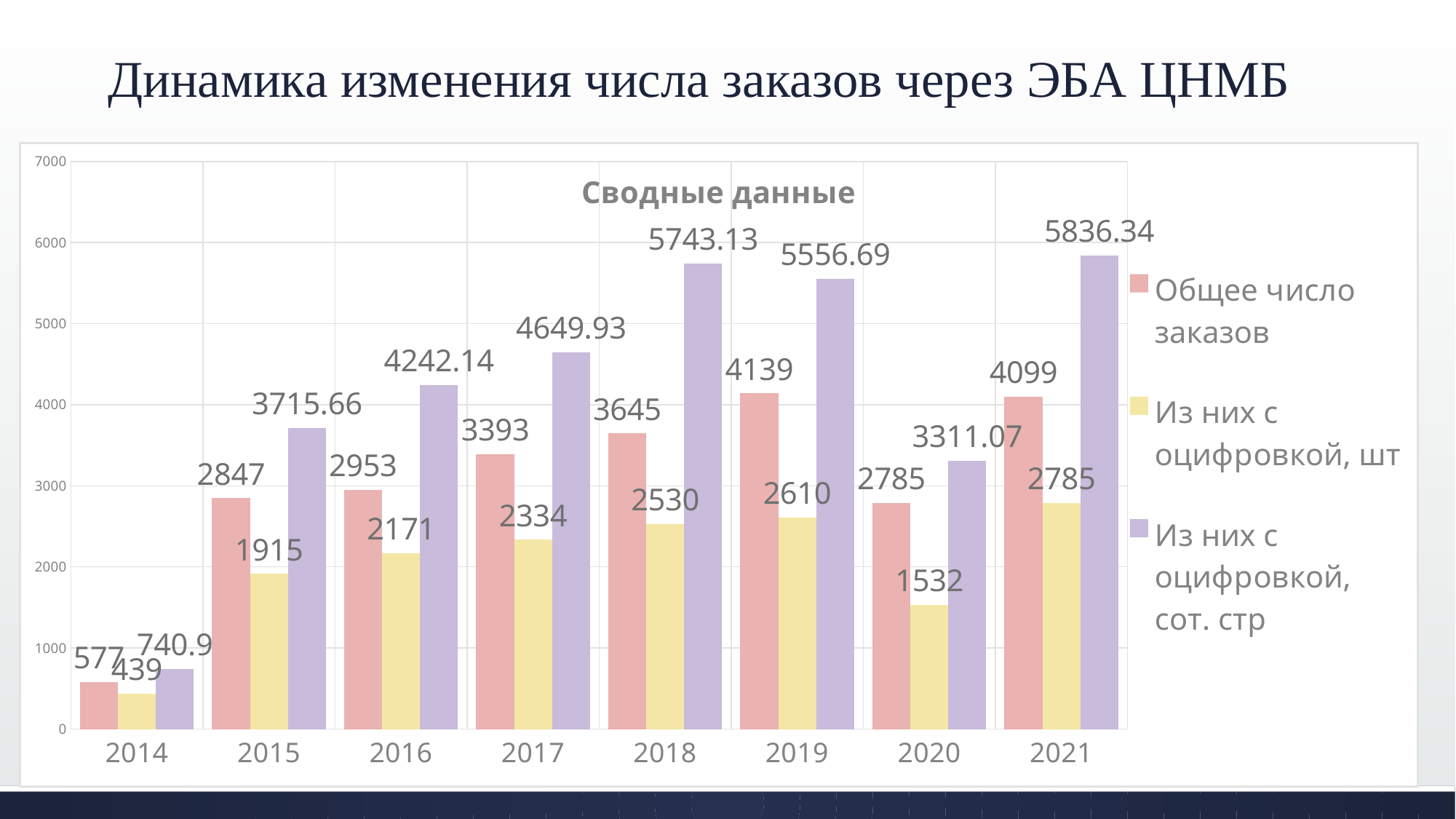
How many series does the legend list? 3 What is the value of 'Из них с оцифровкой, сот. стр' for 2018? 5743.13 In which year is 'Общее число заказов' the lowest? 2014 What is the value of 'Из них с оцифровкой, шт' for 2016? 2171 What type of chart is shown on the slide? bar chart In which year is 'Из них с оцифровкой, сот. стр' the highest? 2021 What is the value of 'Общее число заказов' for 2019? 4139 How many years are shown on the x axis? 8 Which is larger: 'Общее число заказов' in 2018 or in 2020? 2018 What is the difference between 'Общее число заказов' and 'Из них с оцифровкой, шт' in 2021? 1314 What is the title of the chart? Сводные данные Does 'Общее число заказов' rise or fall from 2019 to 2020? fall